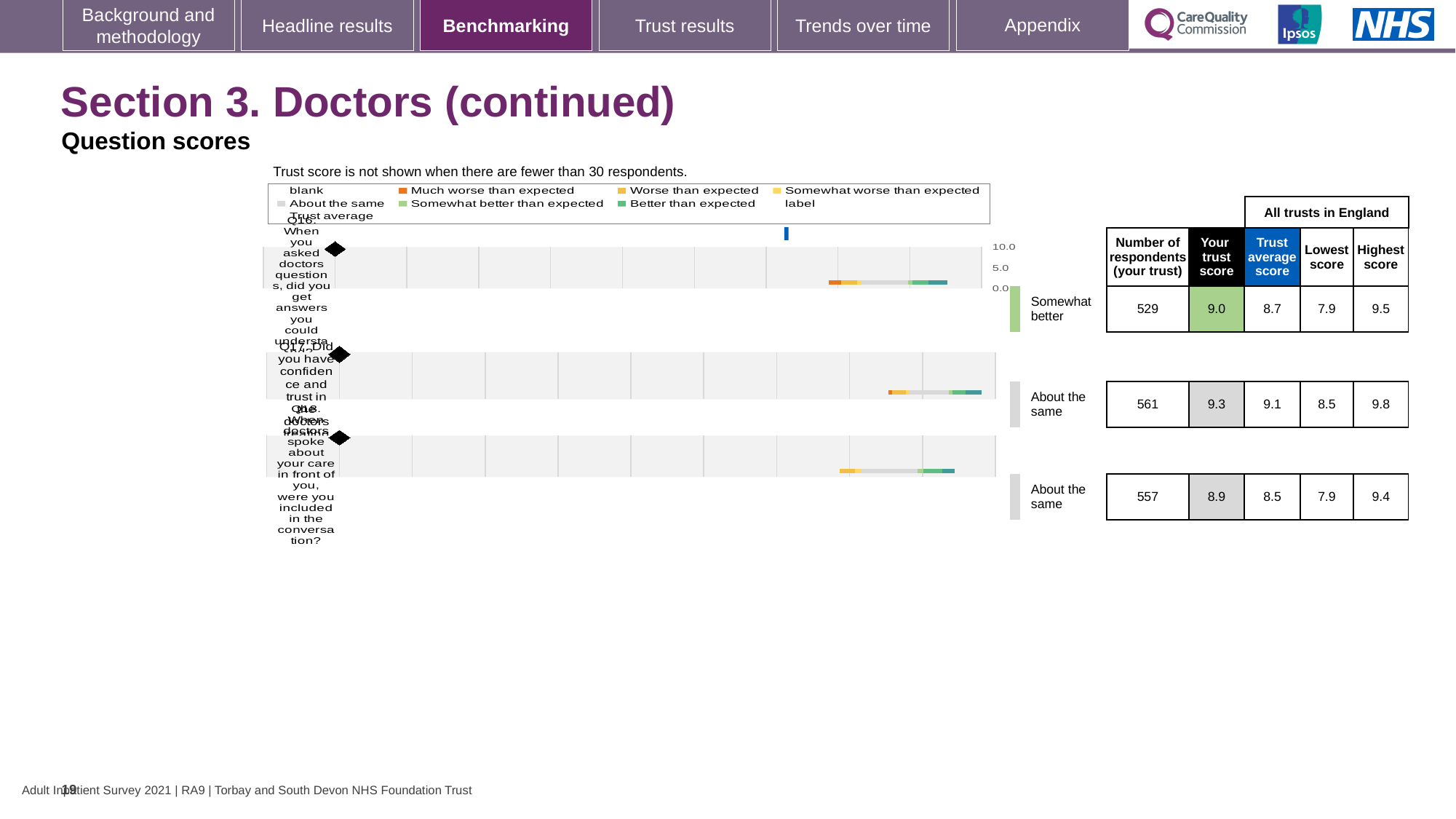
How many questions (Q16, Q17, Q18) are plotted in the chart? 3 What kind of chart is used to show the question scores on this slide? bar chart What is the difference between the trust score and the trust average score for Q16? 0.3 What is the 'Your trust score' for Q17 (confidence and trust in the doctors)? 9.3 What is the difference between the highest score and the lowest score for Q17? 1.3 What is the number of respondents for Q16 (answers you could understand)? 529 What is the maximum value shown on the chart's score axis? 10.0 Which question has the lowest 'Your trust score'? Q18 Which is larger for Q18: the trust score or the trust average score? the trust score What is the trust average score for Q18 (included in the conversation)? 8.5 What benchmark category is shown for Q16? Somewhat better Which question has the highest 'Your trust score'? Q17